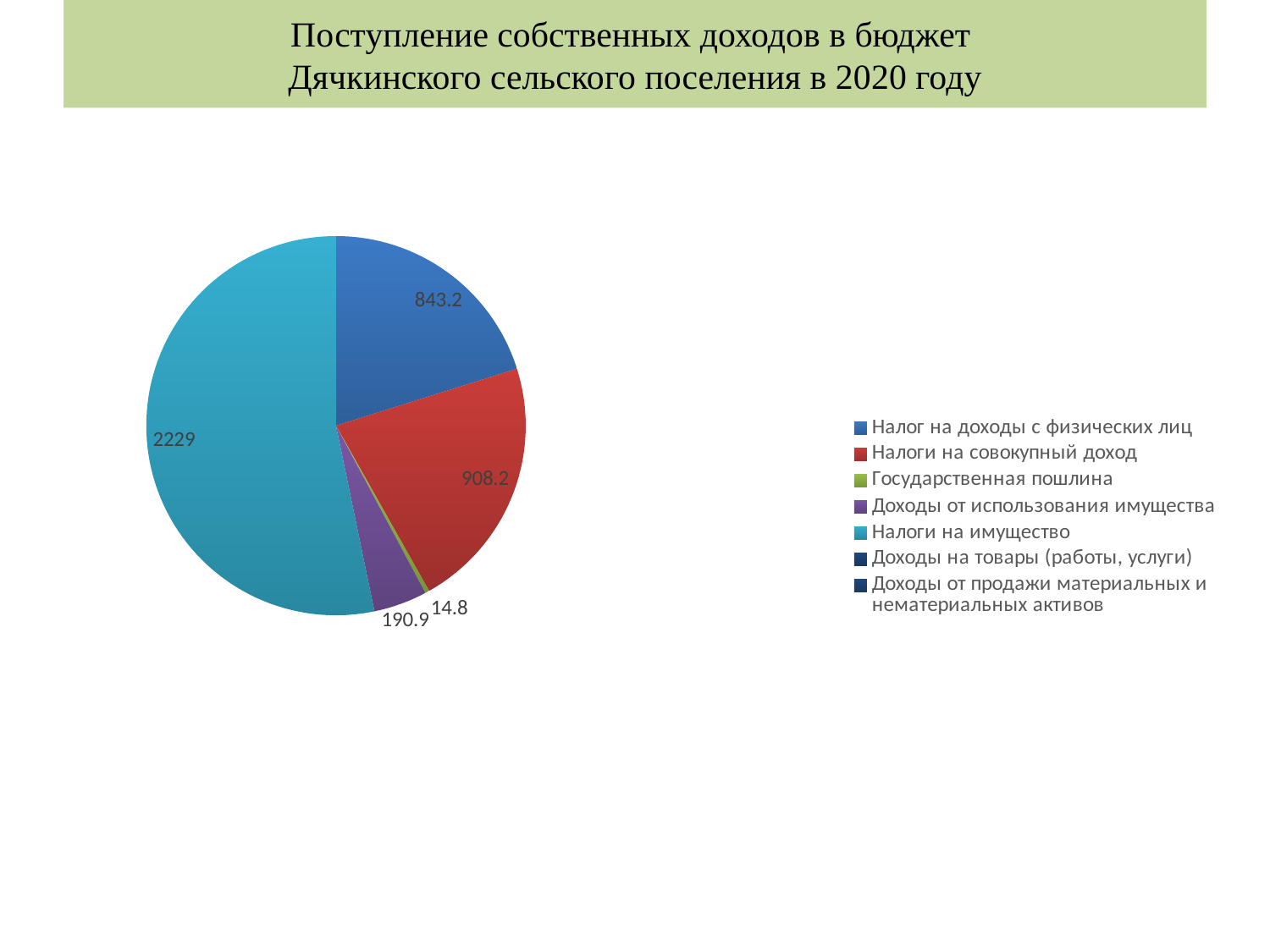
What is the value for Налоги на совокупный доход? 908.2 What is the value for Налог на доходы с физических лиц? 843.2 What is the difference between the values for Доходы от использования имущества and Государственная пошлина? 176.1 Which category has the largest slice of the pie? Налоги на имущество What is the difference between the values for Налоги на совокупный доход and Налог на доходы с физических лиц? 65 What type of chart is shown on the slide? pie chart Among the slices with data labels, which category has the smallest value? Государственная пошлина Which is larger: Налоги на совокупный доход or Налог на доходы с физических лиц? Налоги на совокупный доход What is the value for Налоги на имущество? 2229 What is the value for Доходы от использования имущества? 190.9 How many entries does the legend list? 7 What is the value for Государственная пошлина? 14.8